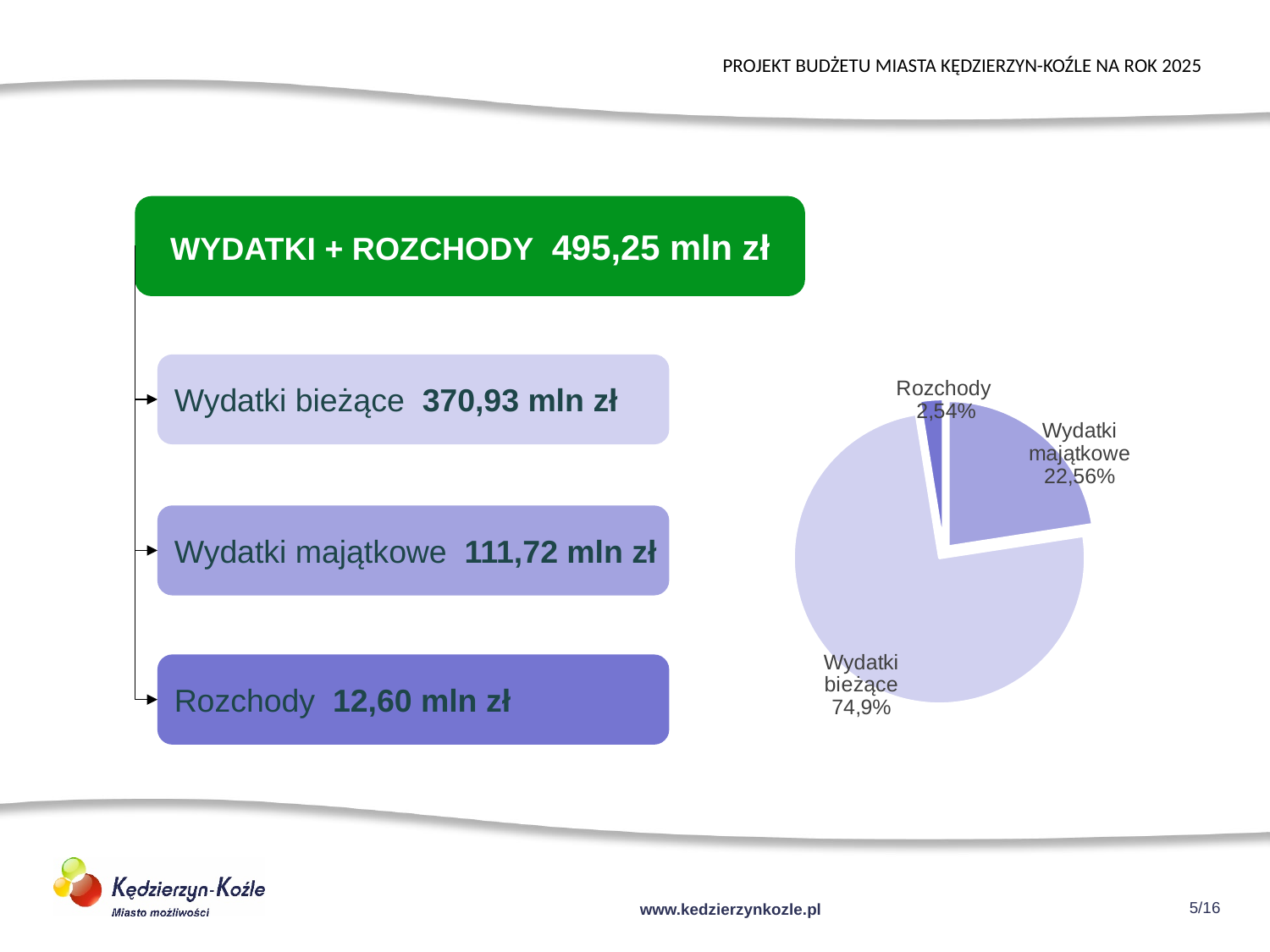
Which slice of the pie chart is the smallest? Rozchody What share of the pie does Wydatki majątkowe represent? 22,56% Which is larger in the pie chart, Wydatki majątkowe or Rozchody? Wydatki majątkowe Does the pie chart have a legend? No What share of the pie does Rozchody represent? 2,54% Which slice of the pie chart is drawn in the darkest shade of purple? Rozchody What kind of chart is shown on the slide? pie chart Which slice of the pie chart is the largest? Wydatki bieżące Is the share for Wydatki bieżące greater or less than 50%? greater How many slices does the pie chart have? 3 What share of the pie does Wydatki bieżące represent? 74,9% What is the difference in percentage points between the Wydatki majątkowe and Rozchody slices? 20,02